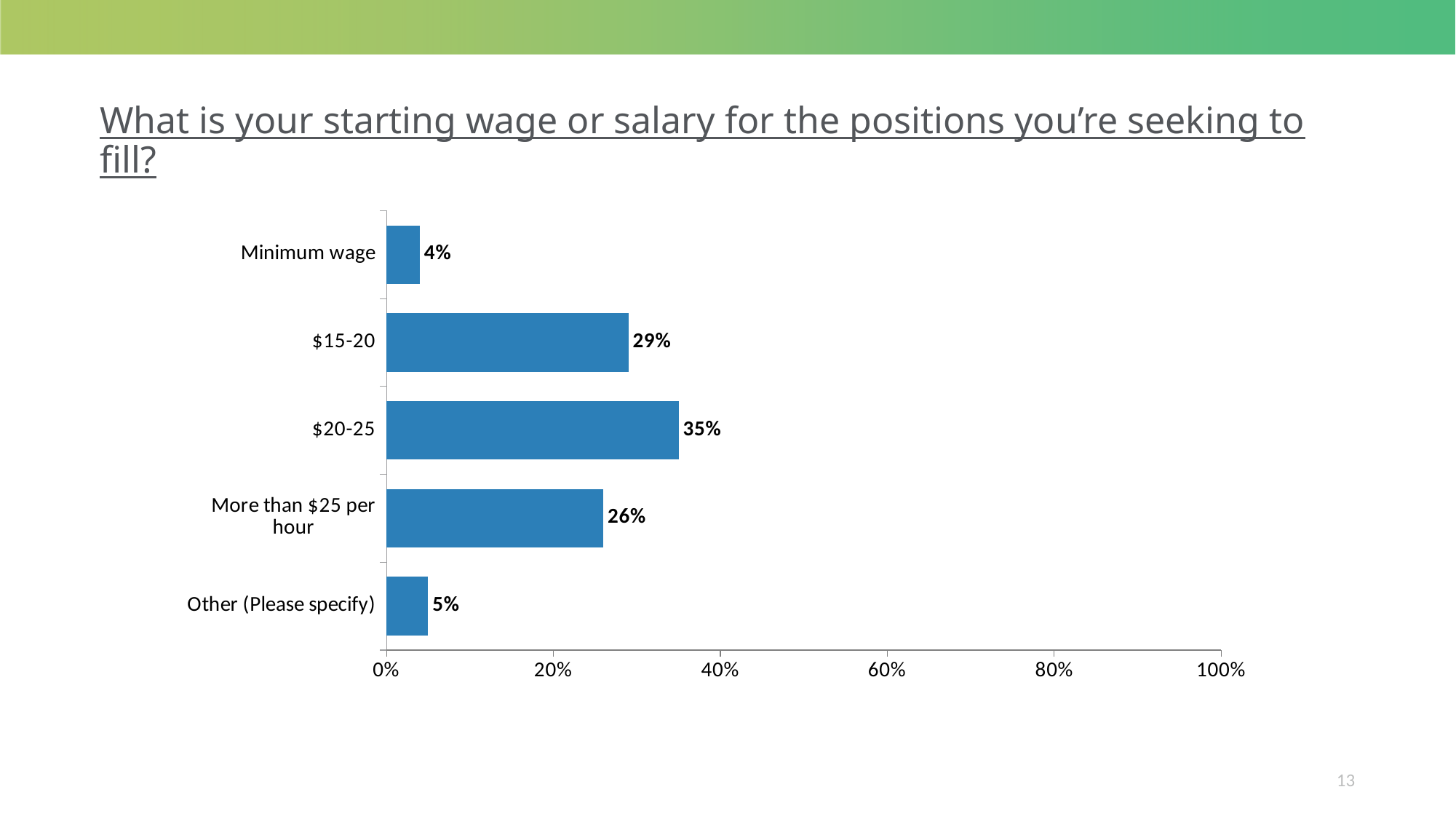
What percentage of respondents reported a starting wage of $20-25? 35% How many categories are shown in the chart? 5 Is the value for $20-25 greater or less than 40%? less Which category has the lowest value? Minimum wage What is the difference between the values for $20-25 and $15-20? 6% Which is larger, the value for $15-20 or the value for More than $25 per hour? $15-20 What percentage is shown for More than $25 per hour? 26% What is the value shown for Minimum wage? 4% Which category has the highest value? $20-25 What is the difference between the values for Other (Please specify) and Minimum wage? 1% What kind of chart is shown on the slide? bar chart What is the highest value shown on the x axis? 100%